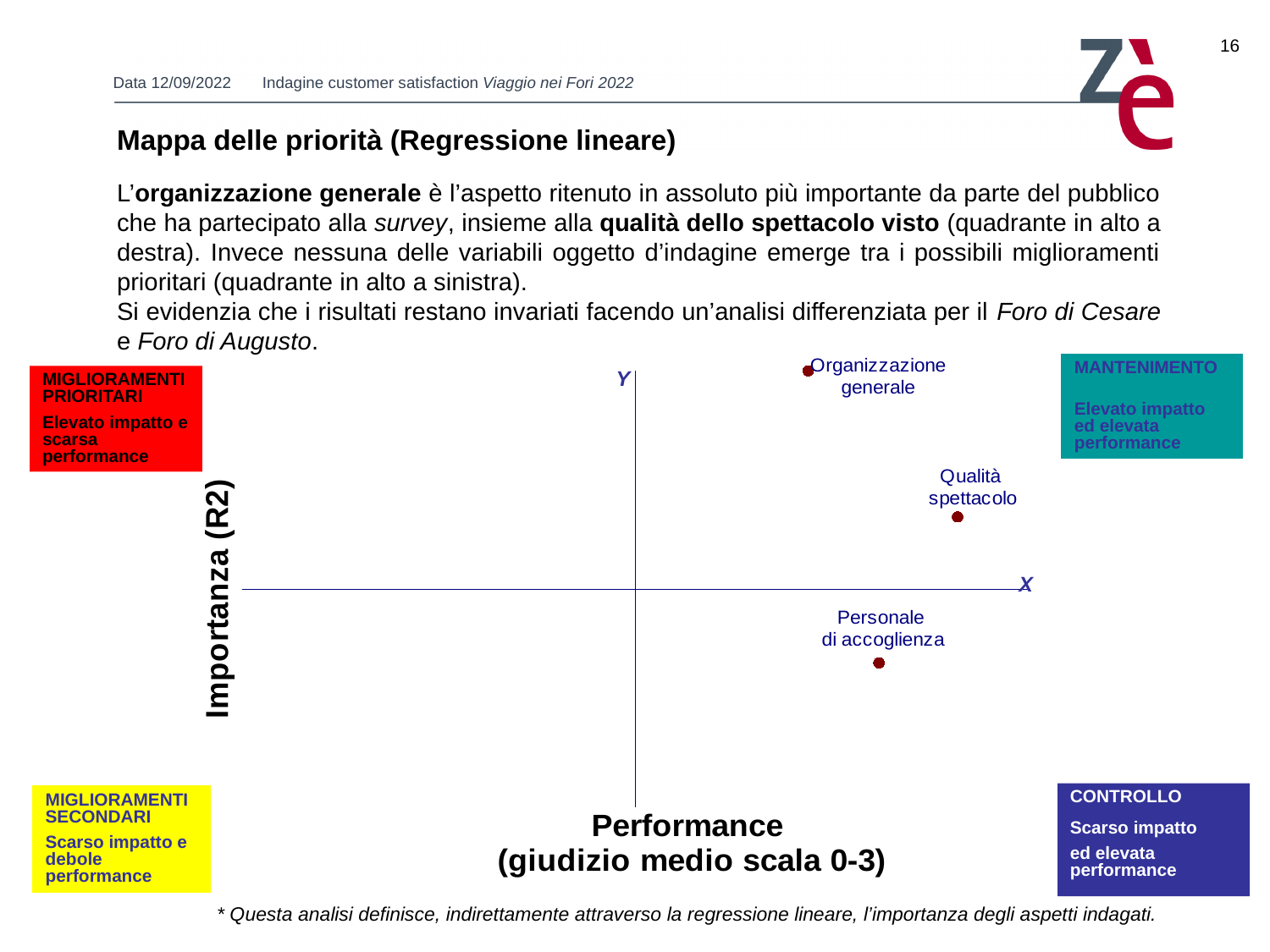
Which has the higher importance (Importanza) value: Organizzazione generale or Qualità spettacolo? Organizzazione generale What is the label of the vertical axis of the chart? Importanza (R2) How many plotted points lie in the upper-left quadrant (MIGLIORAMENTI PRIORITARI)? 0 What is the label of the horizontal axis of the chart? Performance (giudizio medio scala 0-3) Which plotted point has the highest importance (Importanza) value? Organizzazione generale Which plotted point lies in the lower-right quadrant (CONTROLLO) of the chart? Personale di accoglienza Which has the higher importance (Importanza) value: Qualità spettacolo or Personale di accoglienza? Qualità spettacolo Which has the higher performance value: Qualità spettacolo or Organizzazione generale? Qualità spettacolo How many data points are plotted on the chart? 3 How many plotted points lie in the upper-right quadrant (MANTENIMENTO)? 2 What kind of chart is shown on the slide? Scatter plot Which plotted point has the lowest importance (Importanza) value? Personale di accoglienza